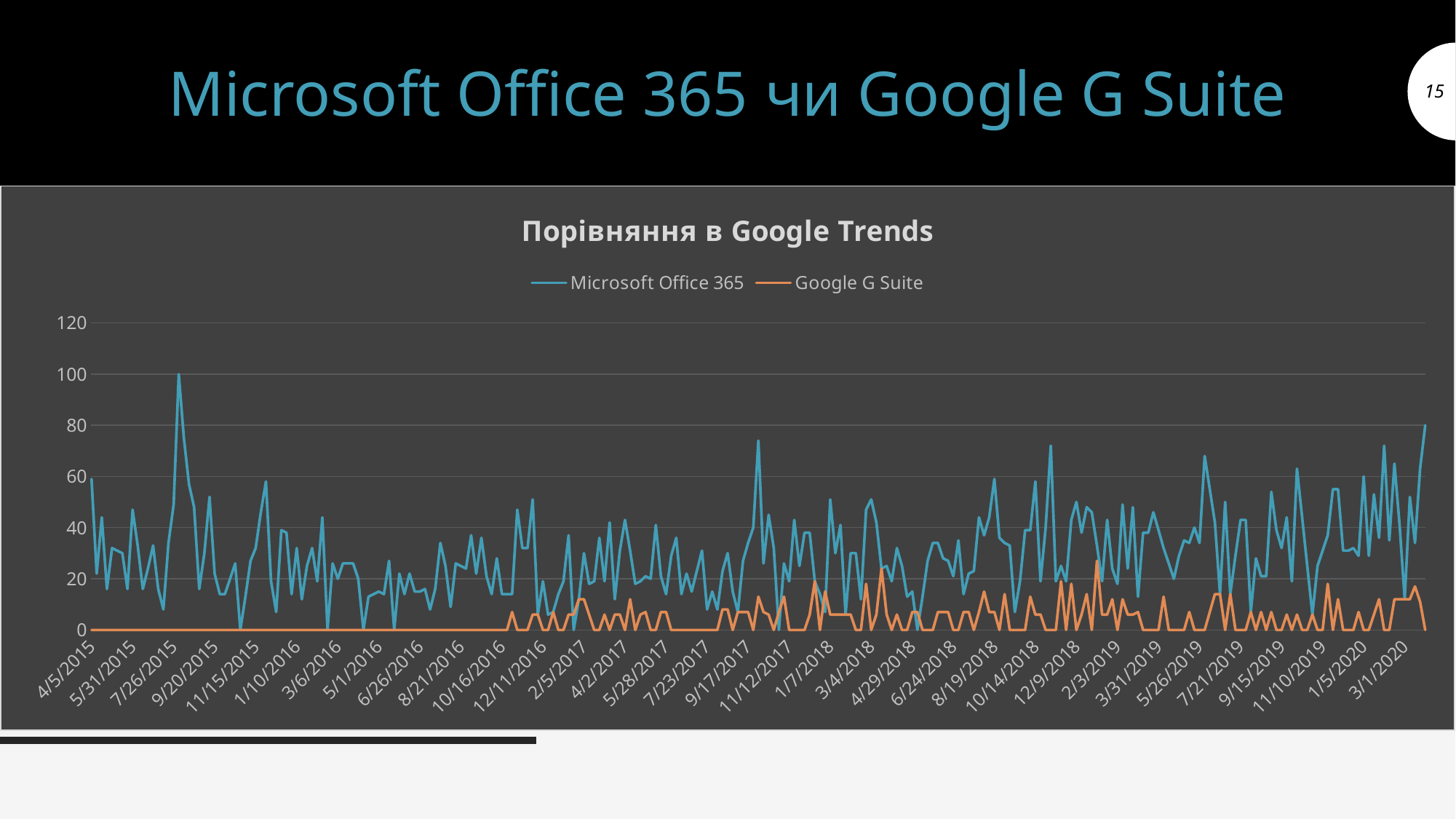
What is the title of the chart? Порівняння в Google Trends Which series is drawn in orange? Google G Suite Which series has the larger value around 7/26/2015, Microsoft Office 365 or Google G Suite? Microsoft Office 365 Is the final value for Microsoft Office 365 at the right end of the chart greater or less than 60? greater How many series does the legend list? 2 Which series reaches the highest value on the chart? Microsoft Office 365 Is the highest value for Google G Suite greater or less than 40? less Is the peak value for Microsoft Office 365 near 7/26/2015 greater or less than 80? greater Which series generally has lower values across the whole period? Google G Suite Does the Google G Suite series rise or fall overall from 2015 to 2020? rise What kind of chart is shown on the slide? line chart